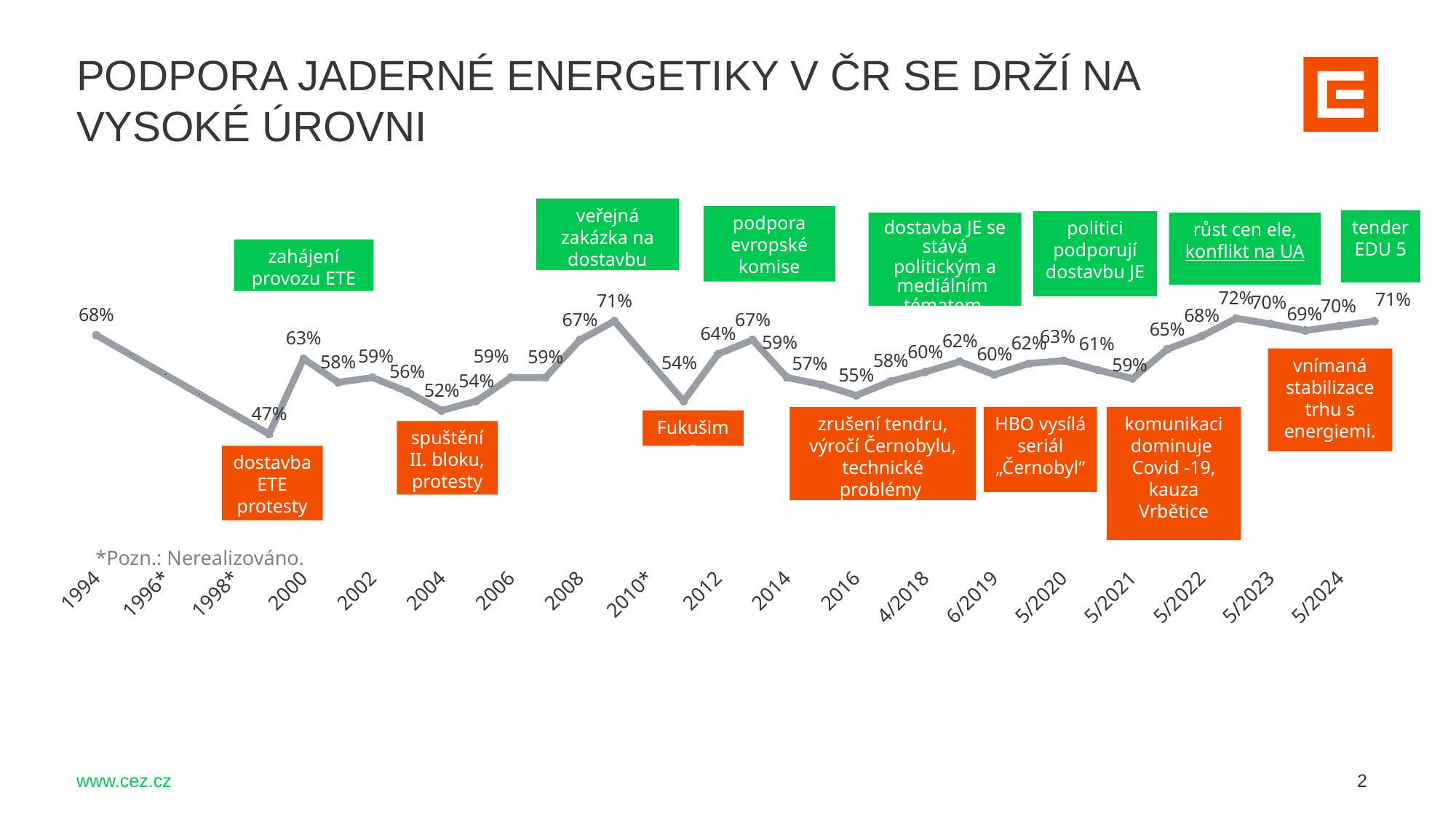
Which is larger: the first data point (1994) or the last data point on the line? the last data point What value is plotted at the dip marked with the 'Fukušima' annotation? 54% How many labels are shown on the x axis of the chart? 19 What is the difference between the highest value (72%) and the lowest value (47%) on the chart? 25 percentage points What is the value of the first (leftmost) data point, at 1994? 68% What is the value of the last (rightmost) data point on the line? 71% What kind of chart is shown on the slide? line chart What is the lowest value shown on the line chart? 47% What is the highest value shown on the line chart? 72% What is the value of the data point directly above the 2000 axis label? 63% What does the green annotation box above the 71% peak say? veřejná zakázka na dostavbu Does the line rise or fall from the 1994 point to the next plotted point? fall